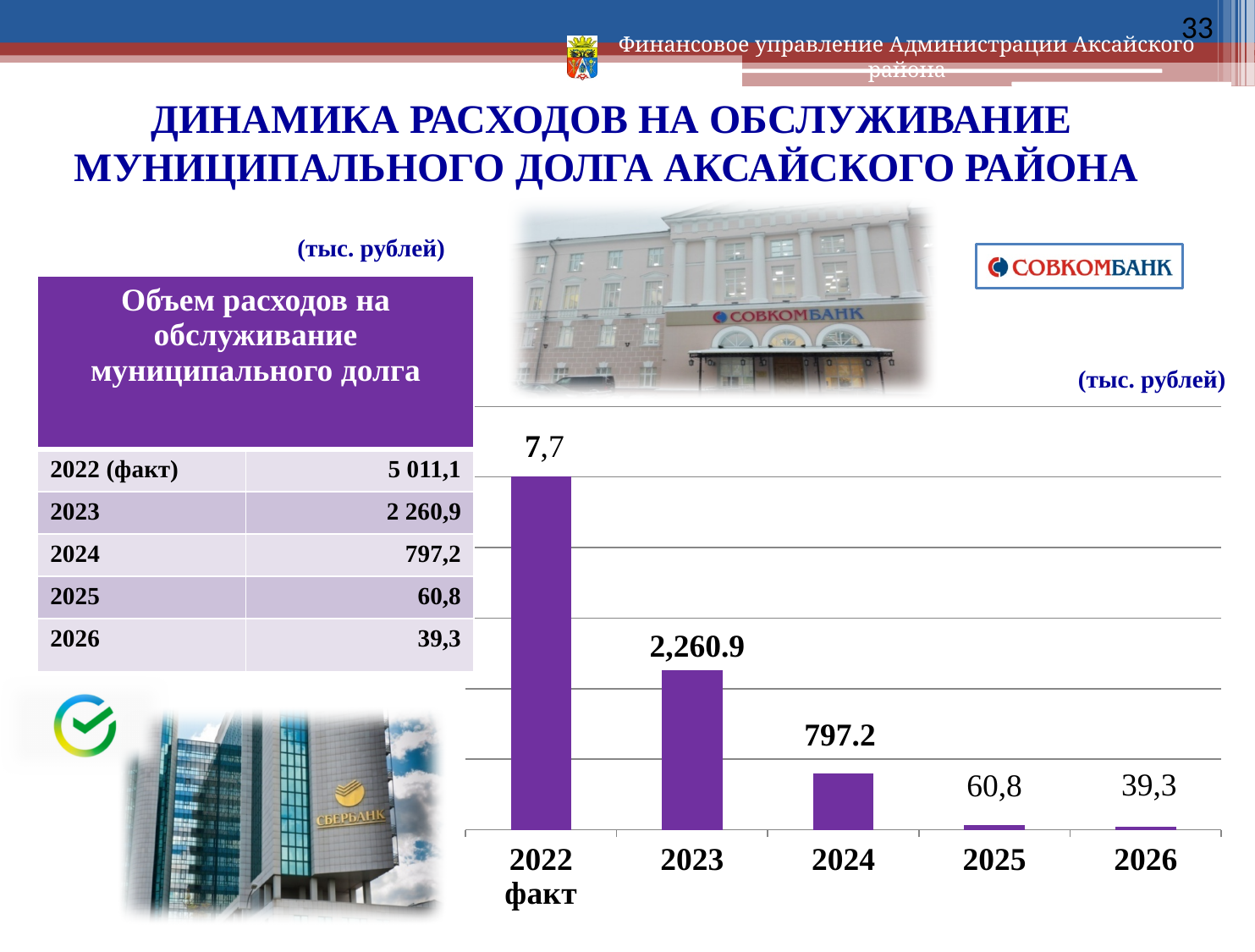
What is the difference between the 2025 value and the 2026 value in the bar chart? 21,5 What is the value shown for 2025 in the bar chart? 60,8 How many years are shown on the x axis of the bar chart? 5 What is the value shown for 2024 in the bar chart? 797.2 Do the values in the bar chart rise or fall from 2022 to 2026? fall What is the value shown for 2026 in the bar chart? 39,3 What is the value shown for 2023 in the bar chart? 2,260.9 Which is larger in the bar chart, the value for 2023 or the value for 2024? 2023 Which year has the smallest bar in the chart? 2026 Which year has the tallest bar in the chart? 2022 факт What kind of chart is shown on the slide? bar chart What is the difference between the 2024 value and the 2025 value in the bar chart? 736.4